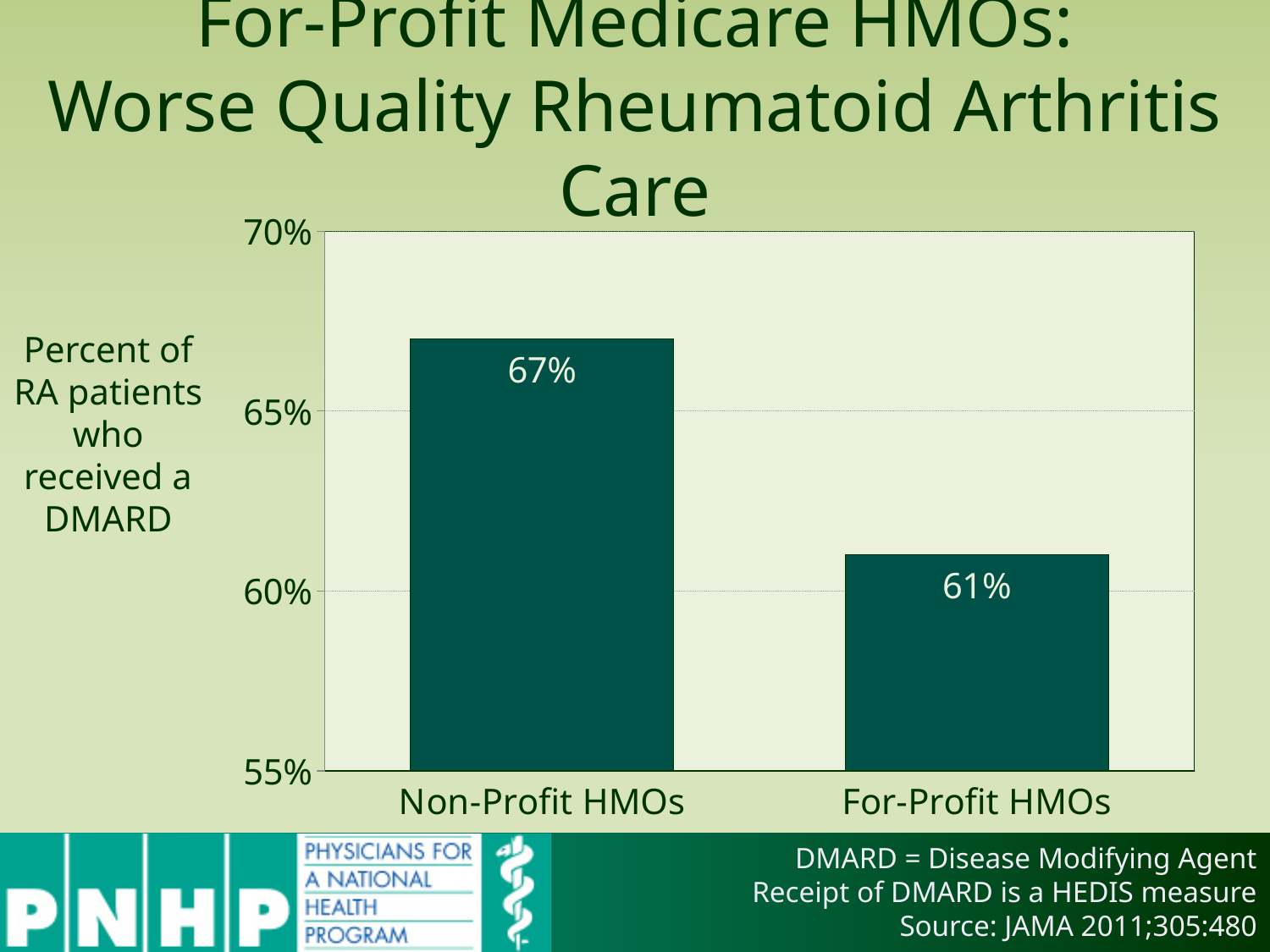
What percent of RA patients received a DMARD in For-Profit HMOs? 61% What kind of chart is shown on the slide? bar chart Is the value for Non-Profit HMOs greater or less than 65%? greater What percent of RA patients received a DMARD in Non-Profit HMOs? 67% What is the difference in percentage points between Non-Profit HMOs and For-Profit HMOs? 6 percentage points Which category has the higher percentage of RA patients receiving a DMARD? Non-Profit HMOs What does the y axis label say the chart measures? Percent of RA patients who received a DMARD How many categories are shown on the x axis? 2 What is the lowest value shown on the y axis? 55% Is the value for Non-Profit HMOs larger or smaller than the value for For-Profit HMOs? larger Is the value for For-Profit HMOs greater or less than 65%? less Which category has the lower percentage of RA patients receiving a DMARD? For-Profit HMOs